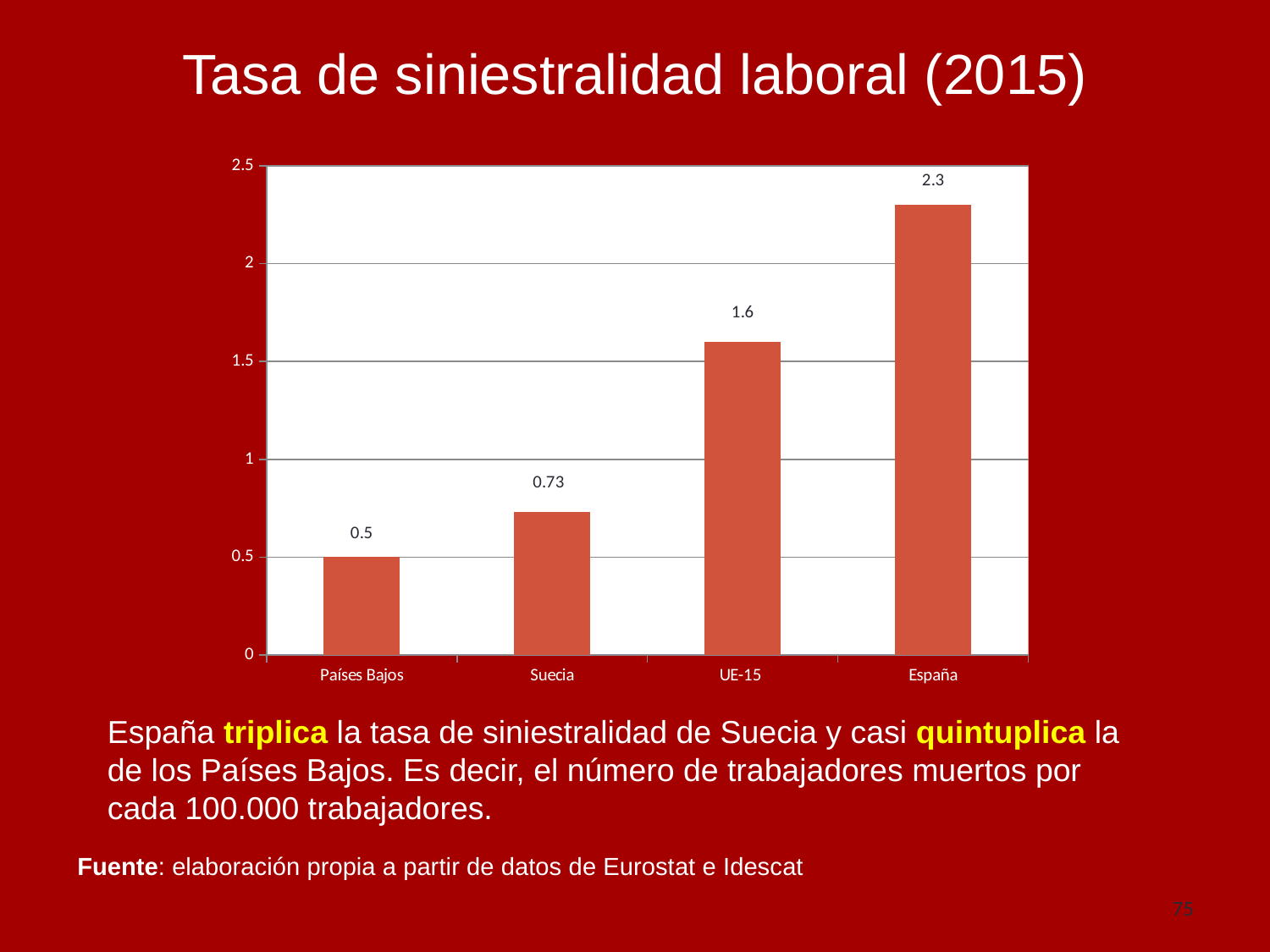
What is the value for UE-15? 1.6 What kind of chart is shown on the slide? Bar chart What is the difference between the values for Suecia and Países Bajos? 0.23 How many categories are shown on the x axis? 4 Which is larger, the value for UE-15 or the value for Suecia? UE-15 What is the title of the chart? Tasa de siniestralidad laboral (2015) Which category has the lowest value? Países Bajos What is the value for Países Bajos? 0.5 Which category has the highest value? España What is the difference between the values for España and UE-15? 0.7 What is the value for Suecia? 0.73 What is the value for España? 2.3